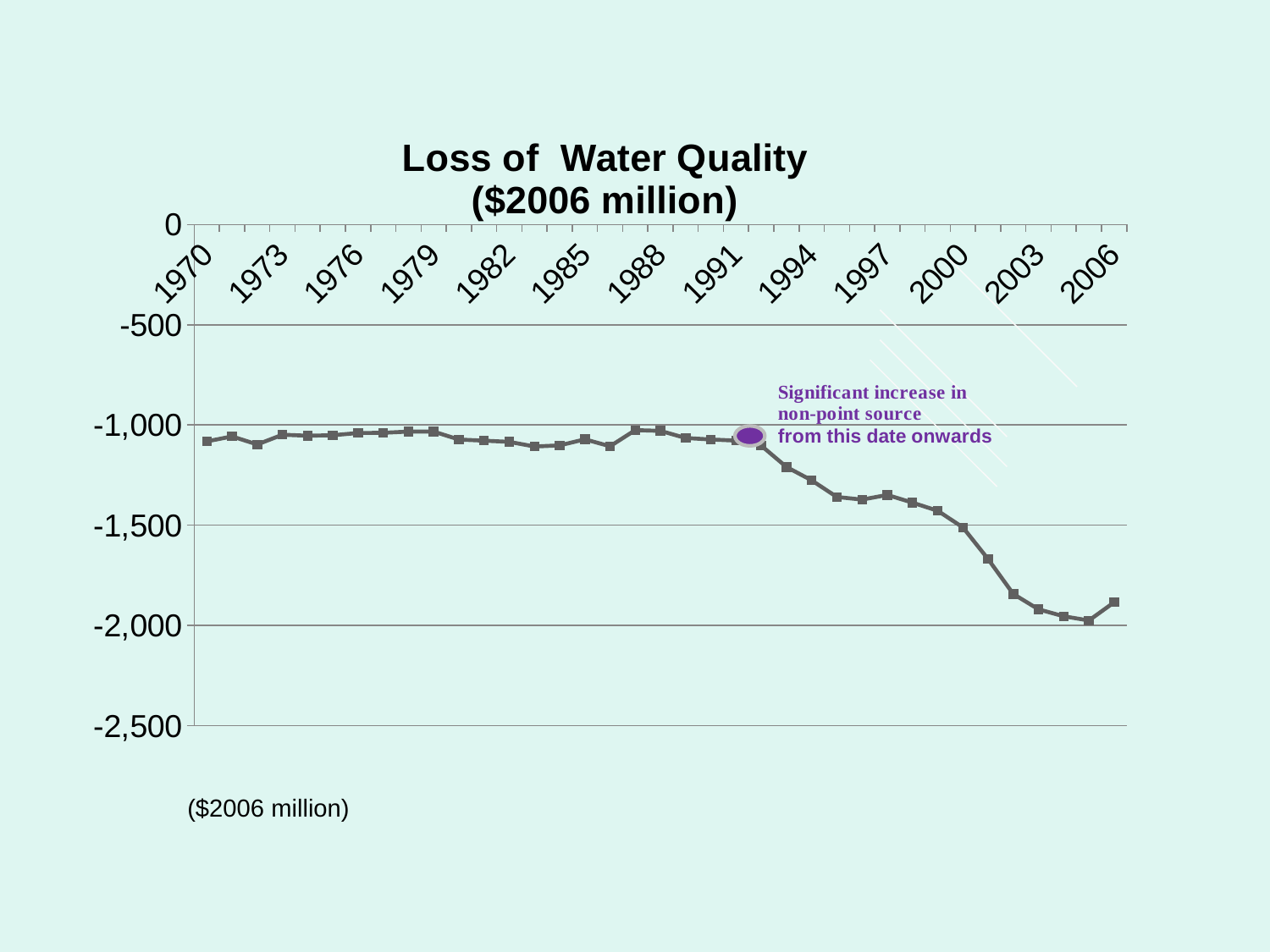
Which year has the larger value, 1994 or 2003? 1994 What kind of chart is shown on the slide? line chart Is the value for 2005 greater or less than -1,500? less How many year labels are shown on the x axis? 13 Which year has the larger value, 1970 or 2006? 1970 Is the value for 1970 greater or less than -1,500? greater What does the annotation next to the highlighted point on the line say? Significant increase in non-point source from this date onwards Is the value for 1994 greater or less than -1,500? greater Do the values generally rise or fall along the x axis from 1991 to 2005? fall What is the title of the chart? Loss of Water Quality ($2006 million)